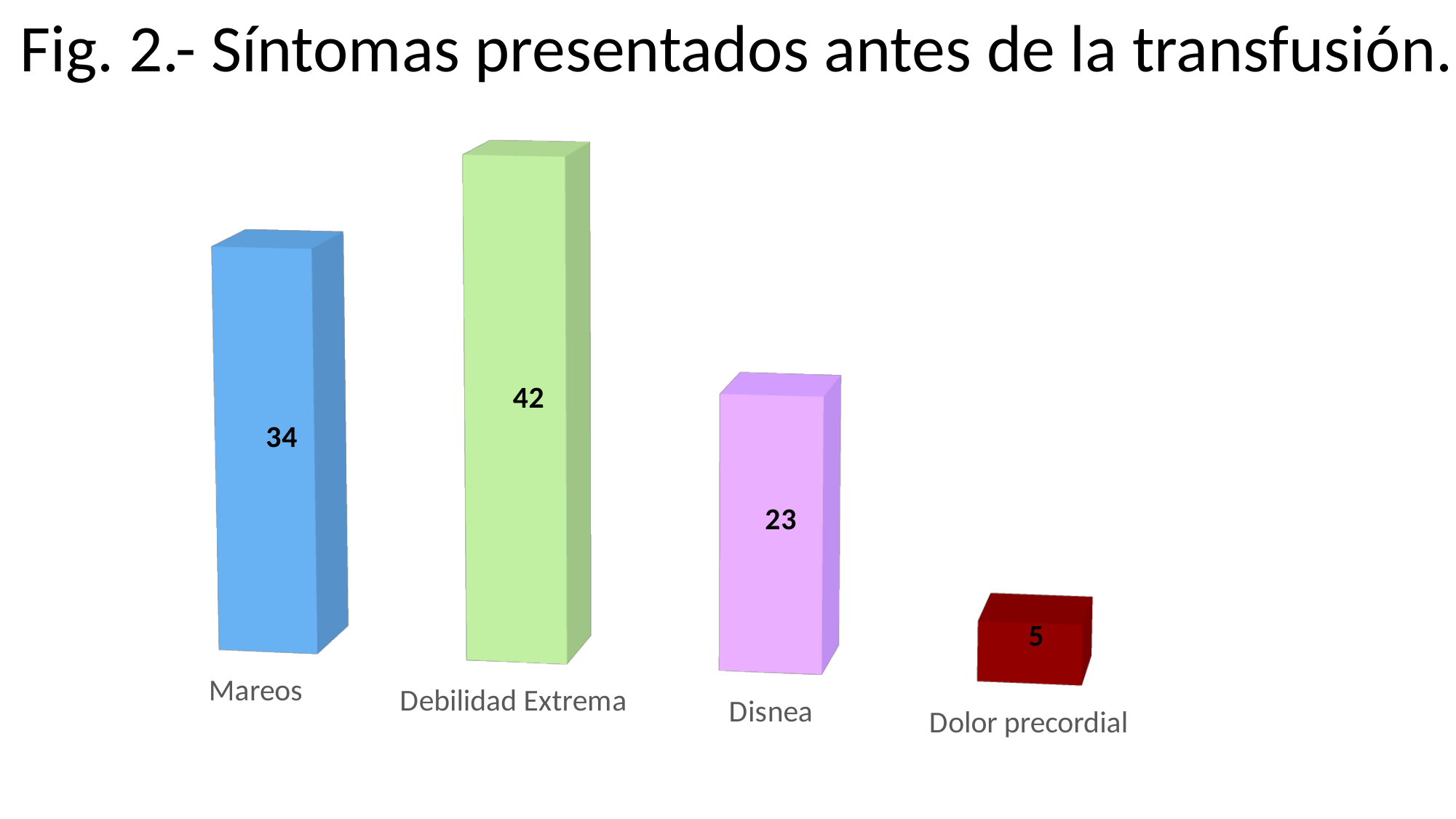
Which is larger, the value for Mareos or the value for Disnea? Mareos Which symptom has the highest value? Debilidad Extrema Which symptom has the lowest value? Dolor precordial What is the difference between the values for Debilidad Extrema and Mareos? 8 How many symptom categories are shown in the chart? 4 What kind of chart is shown on the slide? Bar chart What is the title of the slide? Fig. 2.- Síntomas presentados antes de la transfusión. What is the value for Mareos? 34 What is the value for Dolor precordial? 5 What is the value for Disnea? 23 What is the value for Debilidad Extrema? 42 What is the difference between the values for Disnea and Dolor precordial? 18